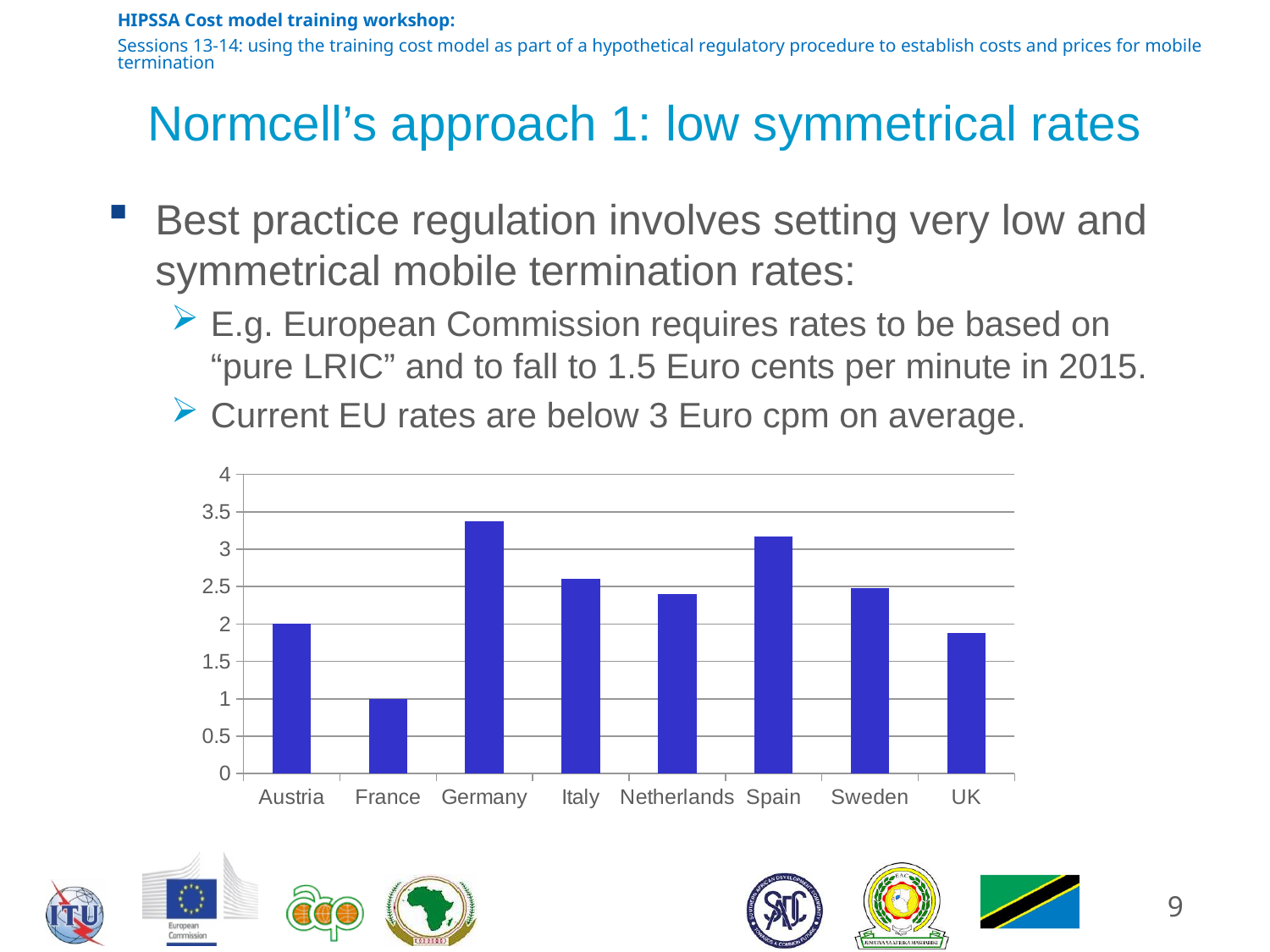
Which country has the highest bar in the chart? Germany Is the value for Germany greater or less than 3? greater How many countries are shown on the x axis of the chart? 8 Which is larger, the value for UK or the value for Sweden? Sweden What kind of chart is shown on the slide? bar chart Which is larger, the value for Spain or the value for Italy? Spain Is the value for Netherlands greater or less than 2? greater Which country has the lowest bar in the chart? France What is the value for France in the chart? 1 Is the value for UK greater or less than 2? less